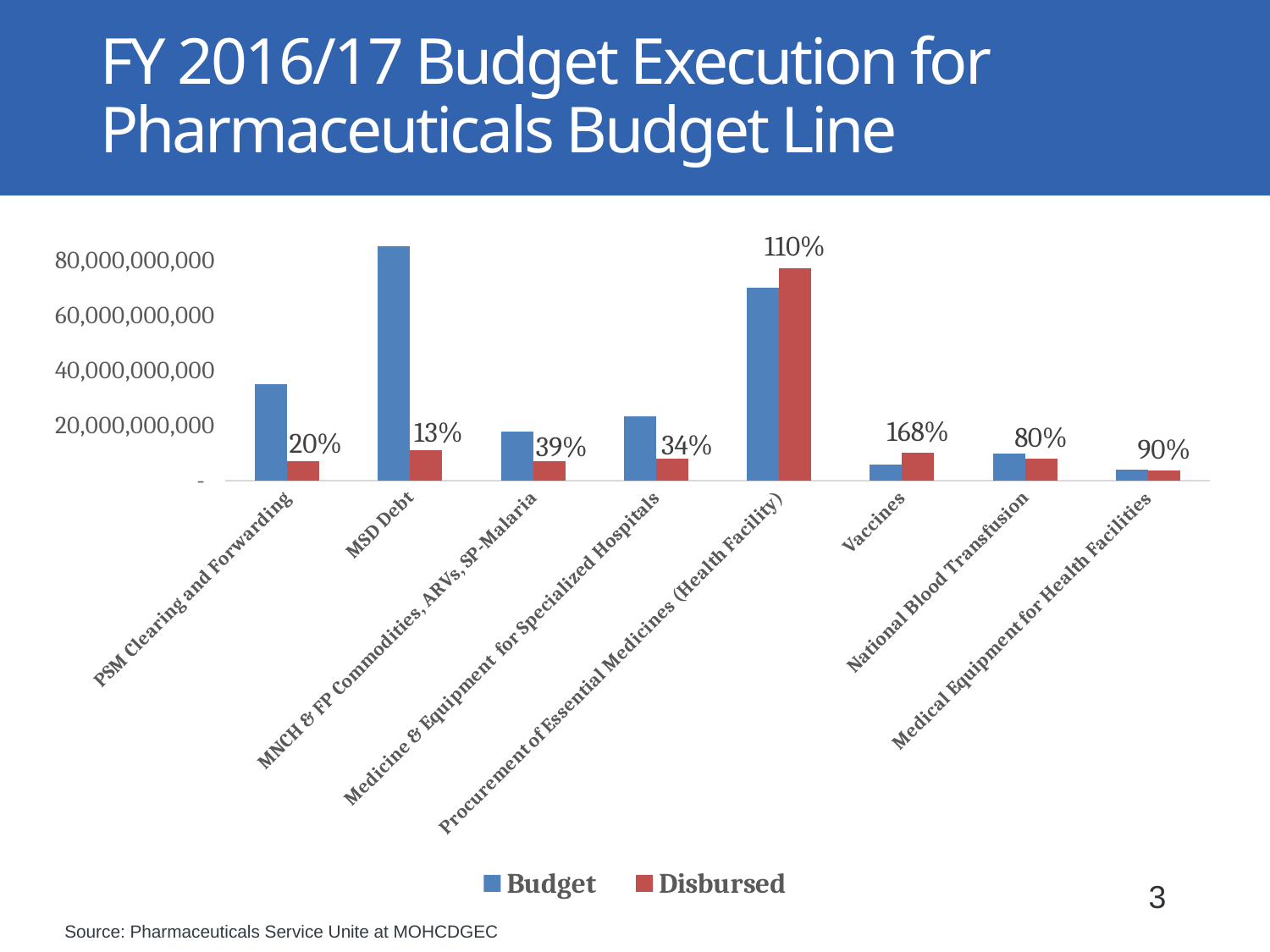
For Vaccines, which is larger, the Budget bar or the Disbursed bar? Disbursed What percentage label is shown for Procurement of Essential Medicines (Health Facility)? 110% What kind of chart is shown on the slide? Bar chart How many series does the legend list? 2 Is the Budget value for PSM Clearing and Forwarding greater or less than 40,000,000,000? less What percentage label is shown for MSD Debt? 13% Which colour represents the Disbursed series in the legend? Red Which category has the tallest Budget bar? MSD Debt Which category has the lowest percentage label? MSD Debt What percentage label is shown for Vaccines? 168% Which category has the tallest Disbursed bar? Procurement of Essential Medicines (Health Facility) How many budget line categories are shown on the x axis? 8